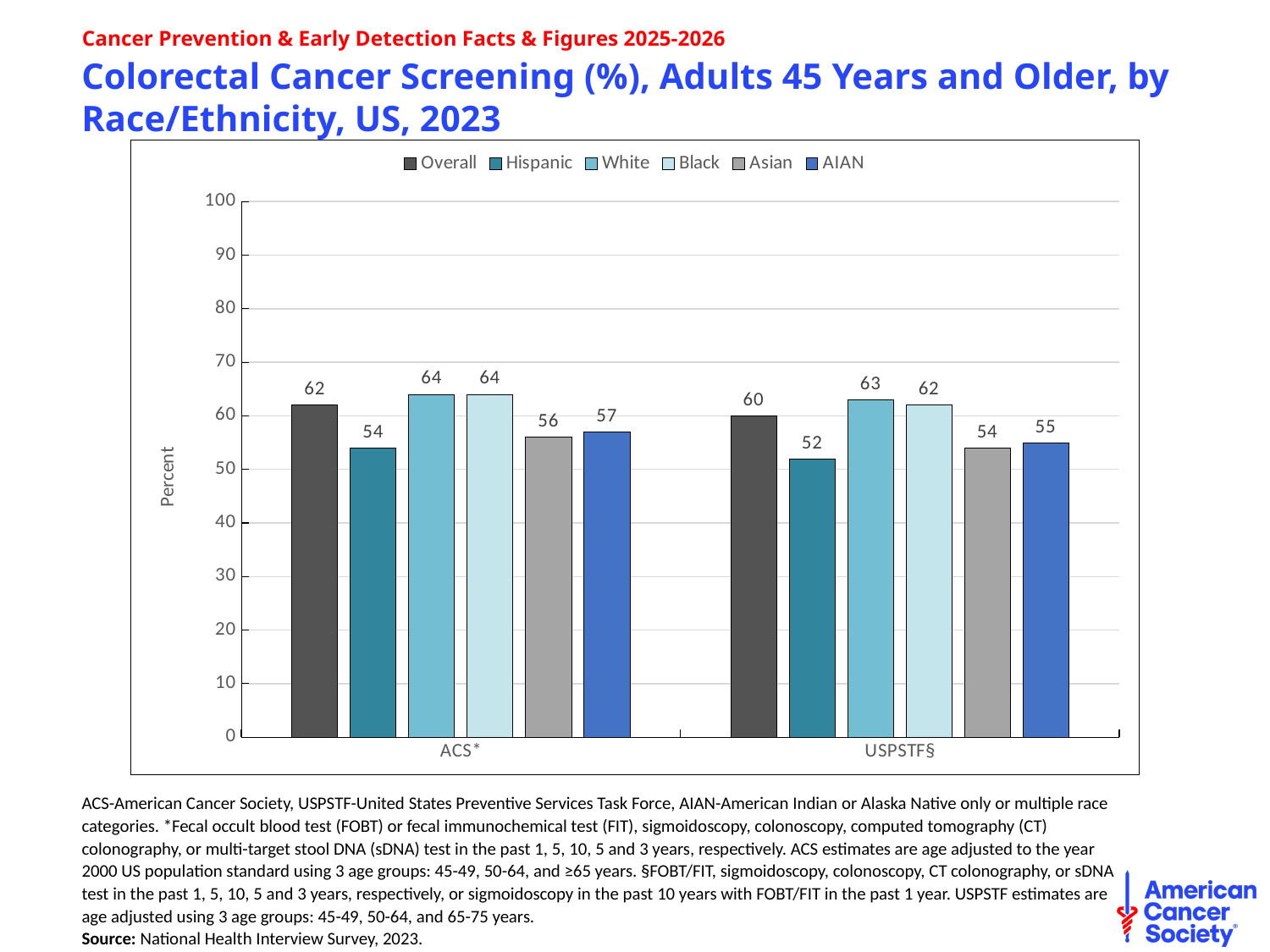
What is the Overall screening percentage under the USPSTF§ guideline? 60 Is the AIAN screening percentage under ACS* greater or less than 50? greater Is the screening percentage for Asian adults higher under ACS* or under USPSTF§? ACS* What is the difference between the White and Hispanic screening percentages under the ACS* guideline? 10 What is the colorectal cancer screening percentage for Black adults under the USPSTF§ guideline? 62 What is the difference between the Overall screening percentage under ACS* and under USPSTF§? 2 How many series does the legend list? 6 Which group has the lowest screening percentage under the USPSTF§ guideline? Hispanic How many guideline categories are shown on the x axis? 2 What type of chart is shown on the slide? Bar chart Which group has the highest screening percentage under the USPSTF§ guideline? White What is the colorectal cancer screening percentage for Hispanic adults under the ACS* guideline? 54